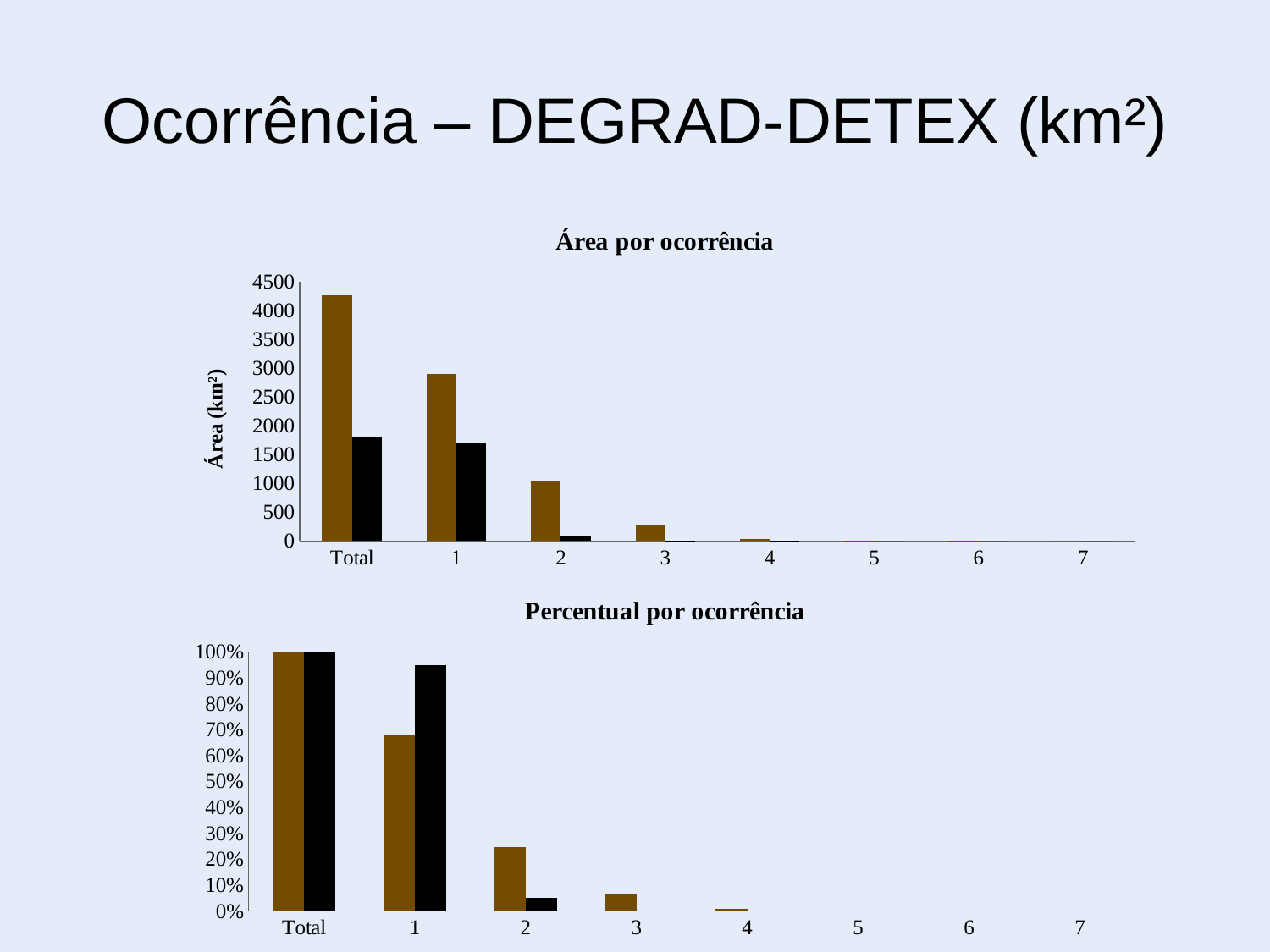
In the 'Área por ocorrência' chart, is the brown bar for Total greater or less than 4000? greater What is the y-axis label of the 'Área por ocorrência' chart? Área (km²) In the 'Percentual por ocorrência' chart, is the black bar for category 1 greater or less than 90%? greater In the 'Área por ocorrência' chart, do the brown bars rise or fall from category 1 to category 7? fall What kind of chart is the 'Área por ocorrência' chart? bar chart In the 'Percentual por ocorrência' chart, is the black bar for category 2 greater or less than 10%? less In the 'Área por ocorrência' chart, which category has the tallest brown bar? Total How many categories are shown on the x axis of the 'Área por ocorrência' chart? 8 In the 'Área por ocorrência' chart, for category 1, which bar is taller, the brown one or the black one? the brown one In the 'Percentual por ocorrência' chart, what is the value of the brown bar for Total? 100%